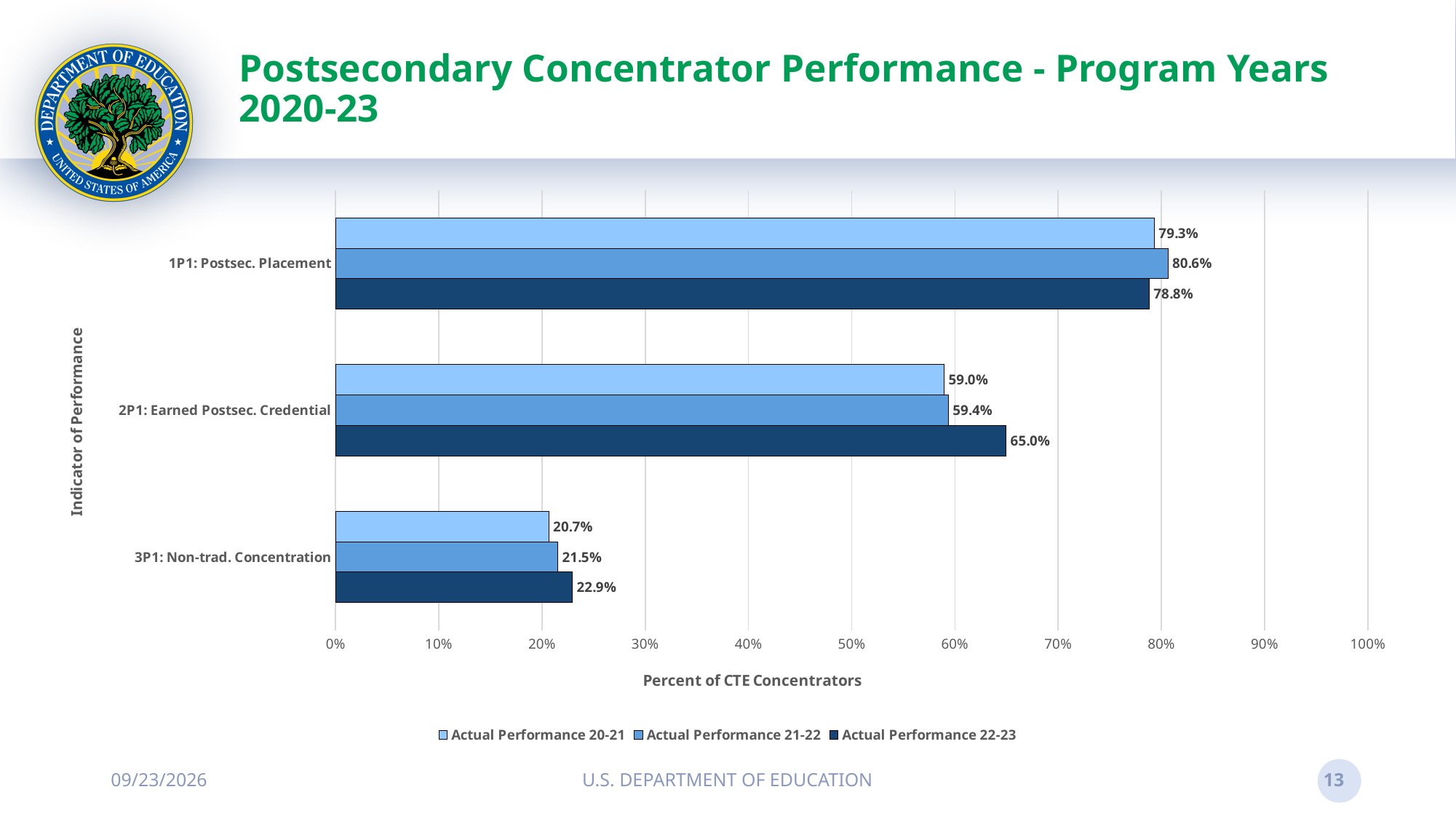
Which indicator has the highest Actual Performance 22-23 value? 1P1: Postsec. Placement What is the difference between the Actual Performance 22-23 and Actual Performance 20-21 values for 2P1: Earned Postsec. Credential? 6.0% How many indicators of performance are shown on the chart? 3 Is the Actual Performance 22-23 value for 3P1: Non-trad. Concentration greater or less than 30%? less What is the Actual Performance 20-21 value for 3P1: Non-trad. Concentration? 20.7% What is the Actual Performance 21-22 value for 1P1: Postsec. Placement? 80.6% For 1P1: Postsec. Placement, which is larger: the Actual Performance 21-22 value or the Actual Performance 22-23 value? Actual Performance 21-22 What is the Actual Performance 22-23 value for 2P1: Earned Postsec. Credential? 65.0% What kind of chart is shown on the slide? bar chart Which indicator has the lowest Actual Performance 21-22 value? 3P1: Non-trad. Concentration How many series does the legend list? 3 What is the label of the horizontal axis? Percent of CTE Concentrators